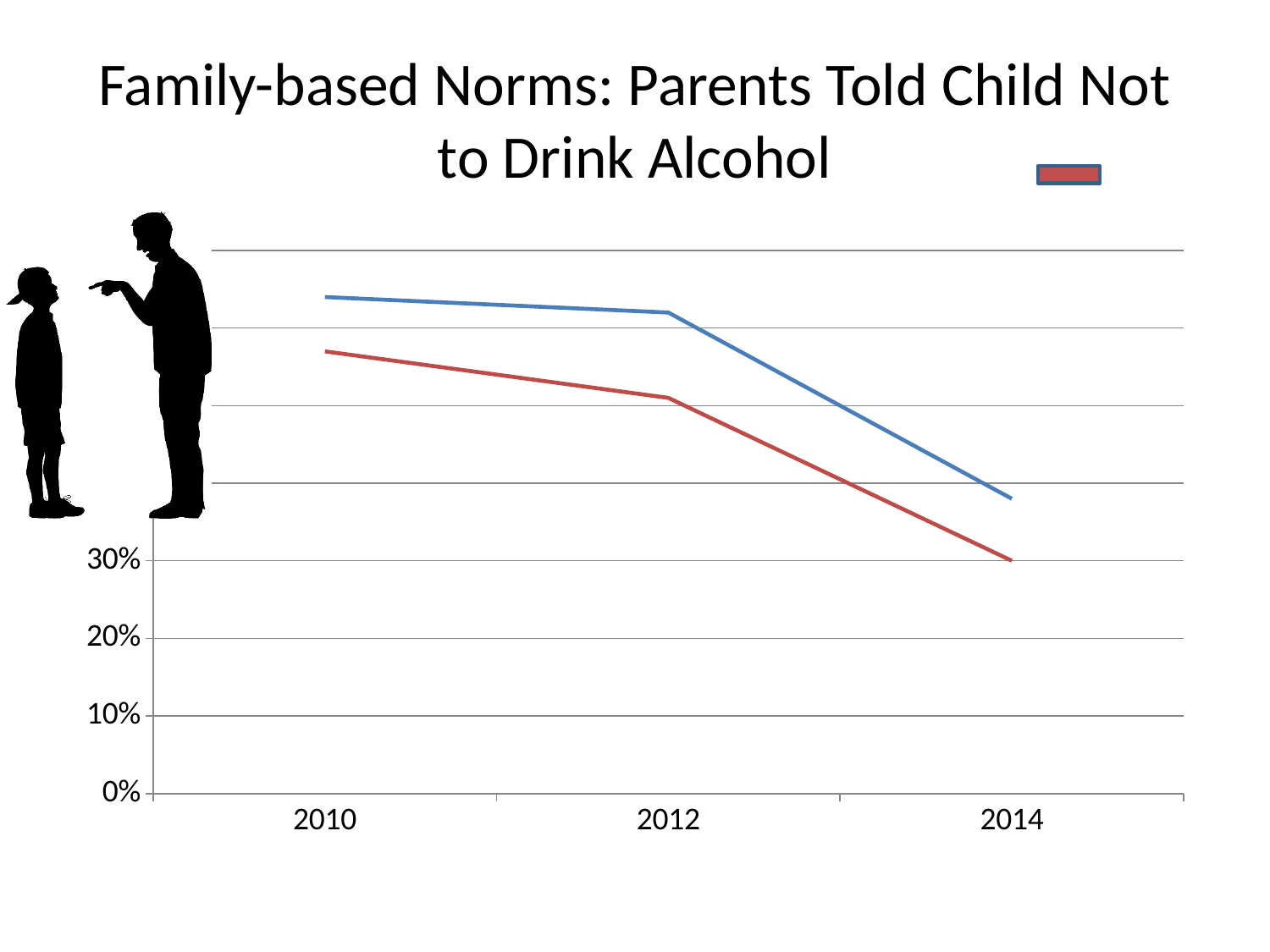
In 2014, which line has the higher value, the blue line or the red line? blue line How many years are plotted along the x axis? 3 How many lines are plotted on the chart? 2 In which year is the red line at its lowest value? 2014 Is the value of the blue line in 2014 greater or less than 30%? greater Do the values of the red line rise or fall from 2010 to 2014? fall What kind of chart is shown on the slide? line chart What is the value of the red line in 2014? 30% Do the values of the blue line rise or fall from 2010 to 2014? fall In which year is the blue line at its highest value? 2010 Is the value of the red line in 2010 greater or less than 30%? greater What is the title of the chart? Family-based Norms: Parents Told Child Not to Drink Alcohol